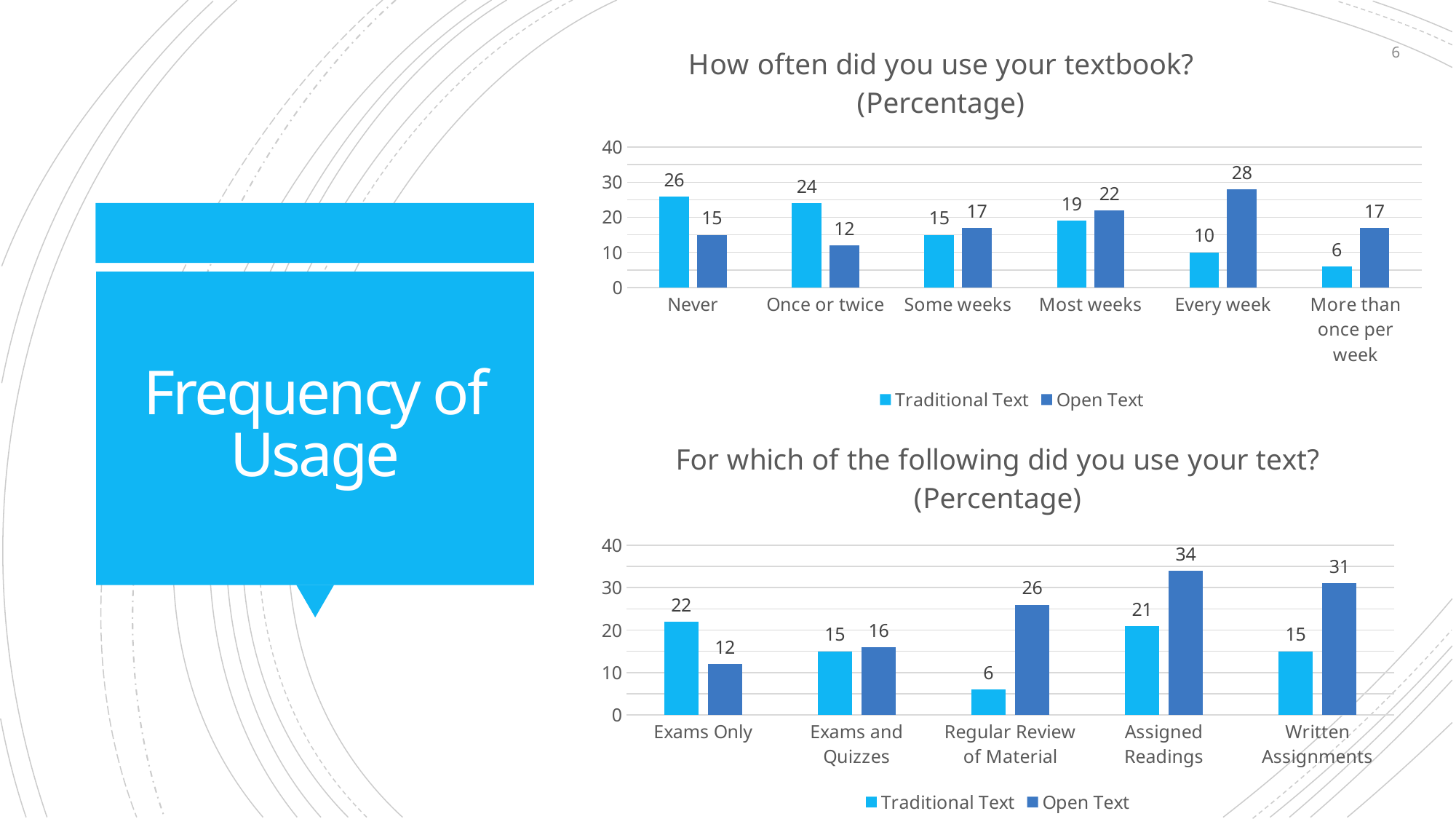
In the chart 'For which of the following did you use your text?', what is the difference between Open Text and Traditional Text at Regular Review of Material? 20 In the chart 'For which of the following did you use your text?', what is the value for Traditional Text at Exams Only? 22 What type of chart is the chart 'For which of the following did you use your text?'? Bar chart In the chart 'For which of the following did you use your text?', which category has the highest Open Text value? Assigned Readings In the chart 'How often did you use your textbook?', what is the value for Traditional Text at Never? 26 In the chart 'For which of the following did you use your text?', what is the value for Open Text at Assigned Readings? 34 In the chart 'How often did you use your textbook?', how many categories are shown on the x axis? 6 In the chart 'How often did you use your textbook?', what is the value for Open Text at Every week? 28 In the chart 'How often did you use your textbook?', what is the difference between Traditional Text and Open Text at Once or twice? 12 In the chart 'For which of the following did you use your text?', how many series does the legend list? 2 In the chart 'How often did you use your textbook?', which category has the lowest Traditional Text value? More than once per week In the chart 'How often did you use your textbook?', which is larger at Most weeks: Traditional Text or Open Text? Open Text